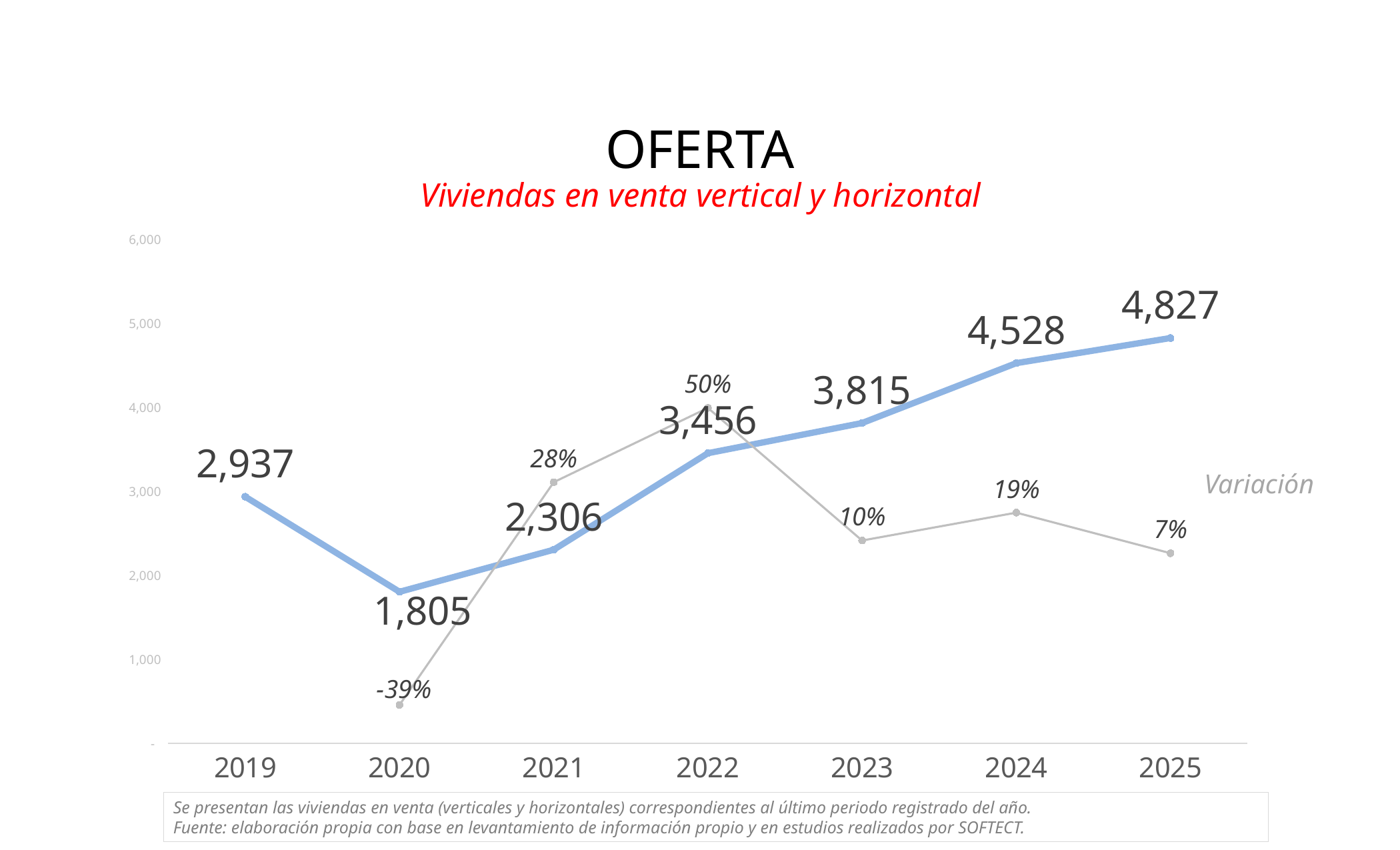
What is the Variación value for 2025? 7% Which year has the highest number of viviendas en venta? 2025 What kind of chart is shown on the slide? Line chart What is the number of viviendas en venta in 2022? 3,456 What is the difference in viviendas en venta between 2025 and 2024? 299 What is the Variación value for 2021? 28% What is the number of viviendas en venta in 2020? 1,805 How many years are shown on the x axis? 7 What is the red subtitle of the chart? Viviendas en venta vertical y horizontal Do the viviendas en venta values rise or fall from 2020 to 2025? Rise Which year has a larger number of viviendas en venta, 2019 or 2021? 2019 Which year has the lowest number of viviendas en venta? 2020